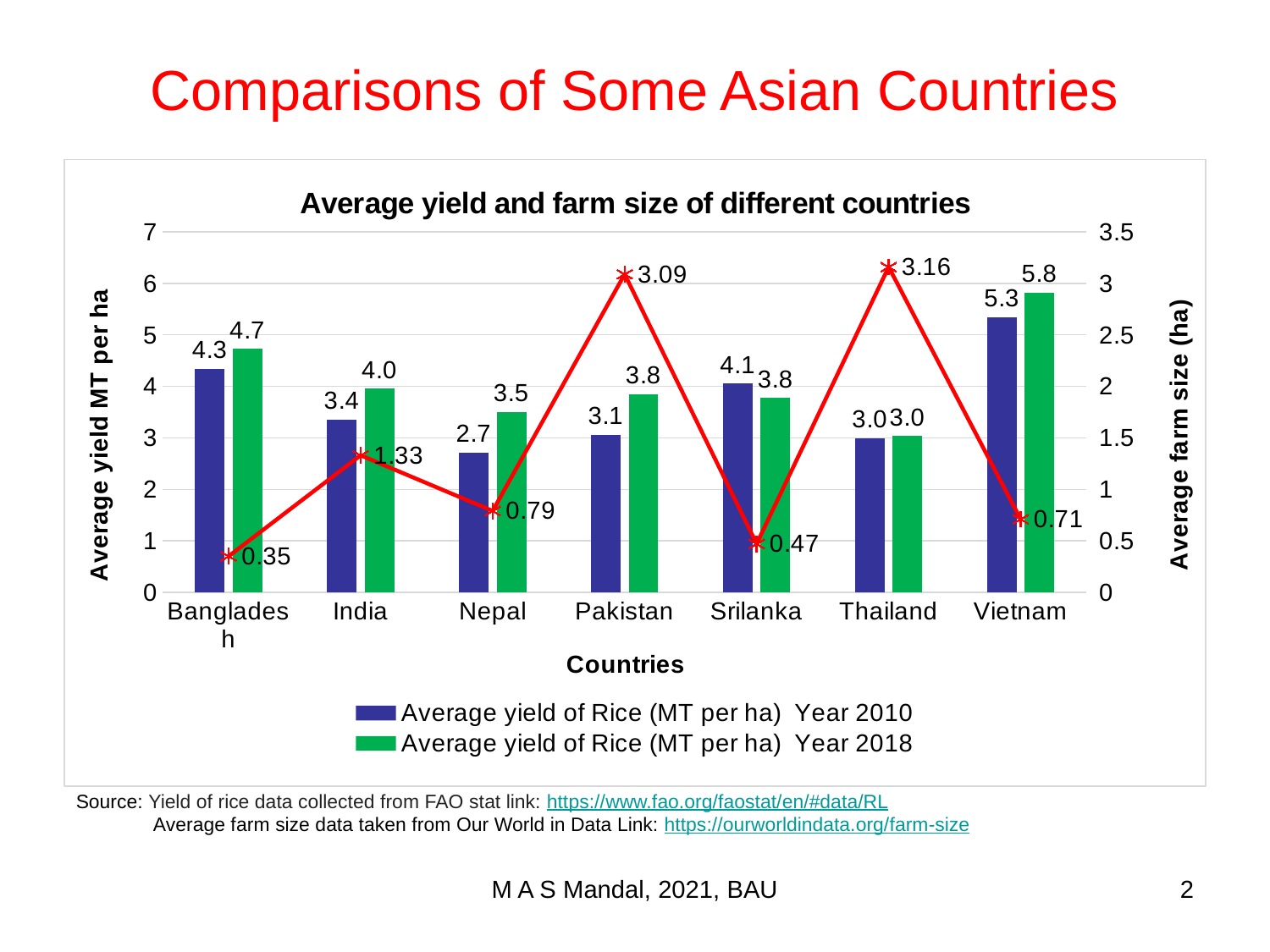
What is the difference between Vietnam's average rice yield in Year 2018 and Year 2010? 0.5 What is the average farm size (ha) shown for Thailand? 3.16 What is the label of the right-hand vertical axis? Average farm size (ha) Which country has the lowest average yield of rice in Year 2010? Nepal Which is larger, Srilanka's average rice yield in Year 2010 or Pakistan's average rice yield in Year 2010? Srilanka What is the title of the chart? Average yield and farm size of different countries What is the average yield of rice in Vietnam in Year 2018? 5.8 How many series does the legend list? 2 Which country has the smallest average farm size on the chart? Bangladesh What is the average yield of rice in Nepal in Year 2010? 2.7 Which country has the highest average yield of rice in Year 2018? Vietnam How many countries are shown on the x axis of the chart? 7